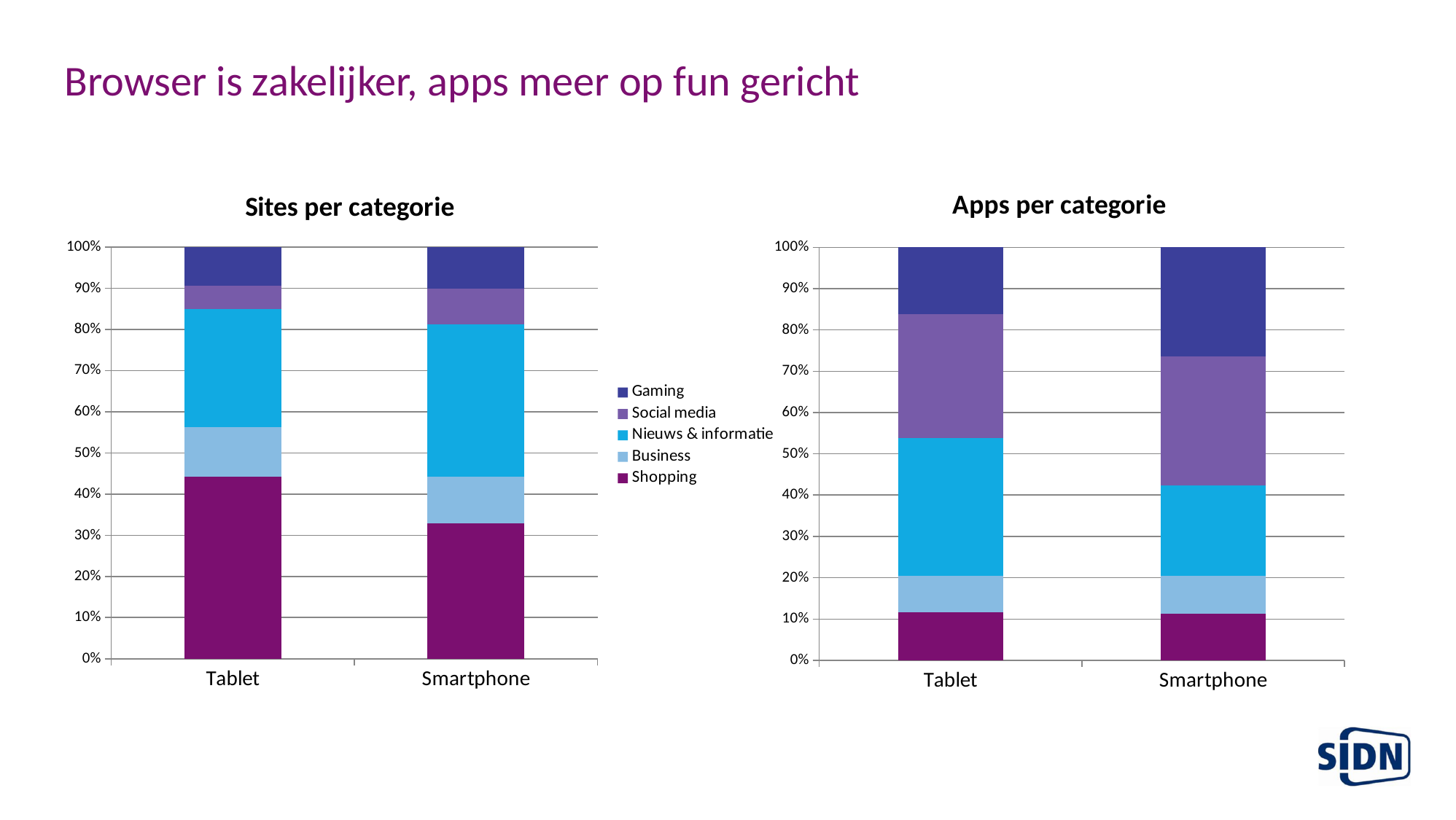
What kind of chart is "Sites per categorie"? bar chart In the "Apps per categorie" chart, which has the larger Gaming share, Tablet or Smartphone? Smartphone In the "Apps per categorie" chart, is the Shopping share for Tablet greater or less than 20%? less In the "Sites per categorie" chart, which has the larger Shopping share, Tablet or Smartphone? Tablet How many series does the legend list? 5 In the "Sites per categorie" chart, is the Shopping share for Tablet greater or less than 40%? greater What is the title of the chart on the right of the slide? Apps per categorie In the "Apps per categorie" chart, is the Gaming share for Smartphone greater or less than 20%? greater In the "Sites per categorie" chart, which category makes up the largest segment of the Tablet bar? Shopping Which legend entry is shown in the darkest purple colour at the bottom of the bars? Shopping How many categories are shown on the x axis of the "Apps per categorie" chart? 2